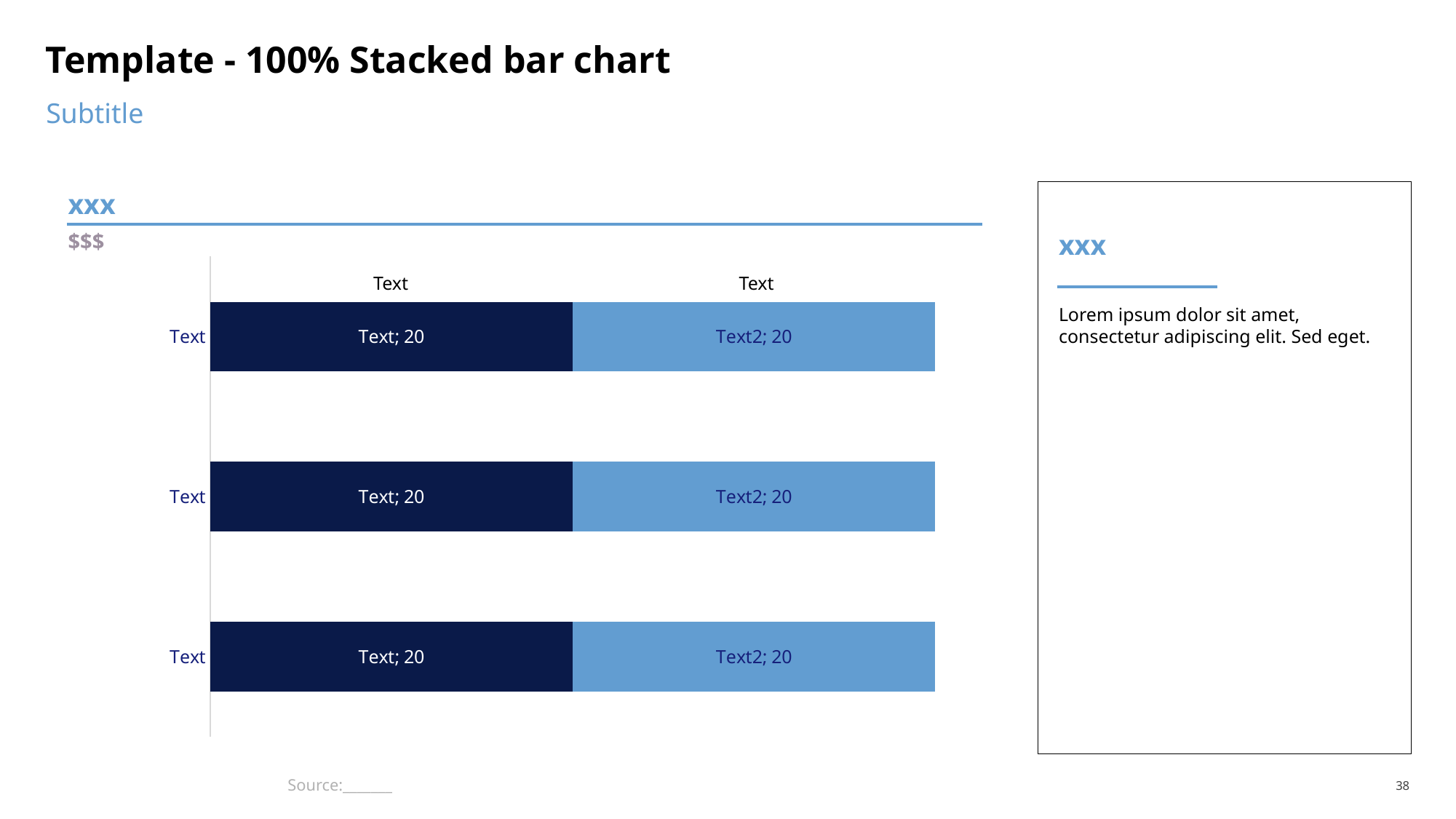
What kind of chart is shown on the slide? Stacked bar chart What is the title shown above the chart? xxx What is the value of the dark blue segment in the middle bar? 20 What is the value of the Text2 segment in the bottom bar? 20 Which colour is used for the Text2 series segments? Light blue What is the value of the Text2 segment in the top bar? 20 Do the values of the dark blue segments rise, fall, or stay the same from the top bar to the bottom bar? Stay the same What is the total of the two segments in the bottom bar? 40 How many bars does the chart contain? 3 What is the total of the two segments in the top bar? 40 What is the difference between the Text segment and the Text2 segment in the middle bar? 0